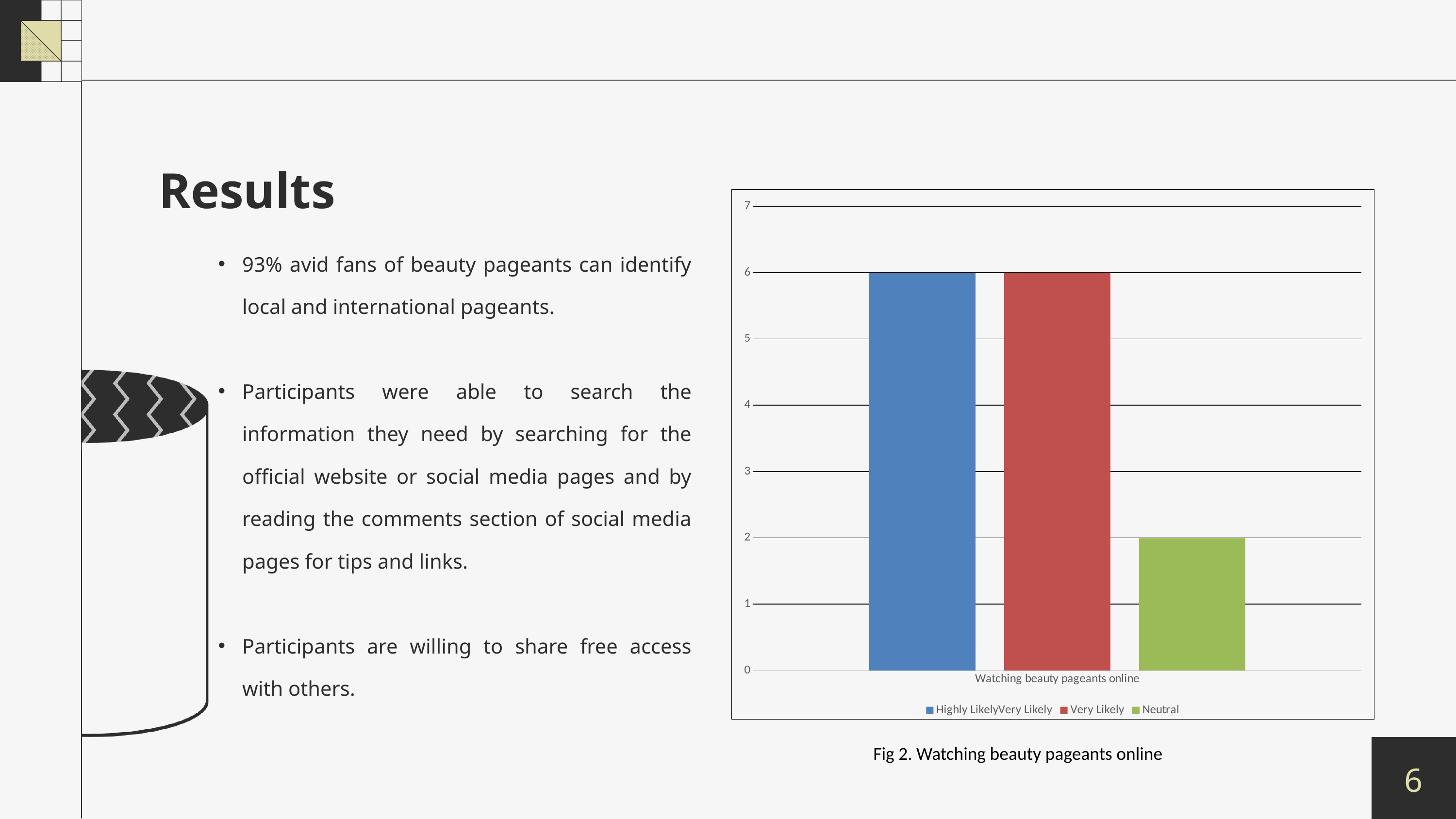
What type of chart is shown on the slide? bar chart Is the value for Neutral greater or less than 4? less What is the category label shown on the x axis of the chart? Watching beauty pageants online What colour is the Neutral bar in the chart? green How many series does the legend list? 3 What is the value of the Neutral bar in the chart? 2 Which series has the lowest value in the chart? Neutral Is the value for Very Likely greater or less than 5? greater What is the difference between the Very Likely value and the Neutral value? 4 What is the value of the blue bar (Highly LikelyVery Likely) in the chart? 6 What is the value of the Very Likely bar in the chart? 6 Which is larger, the Very Likely value or the Neutral value? Very Likely